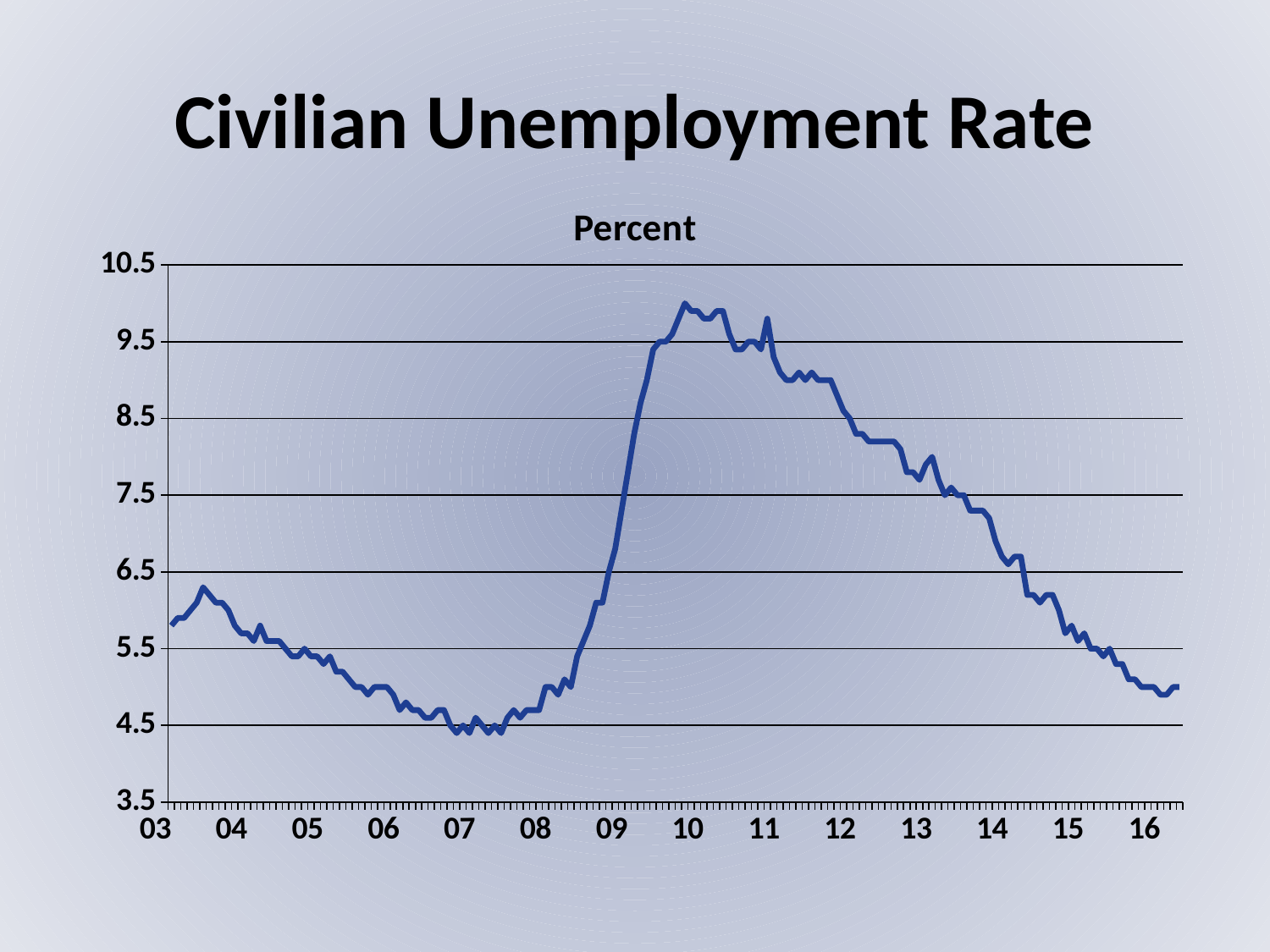
What unit label is shown above the chart's plot area? Percent Is the unemployment rate at the start of 2016 greater or less than 5.5? less In which year labelled on the x axis does the unemployment rate reach its highest point? 09 Does the unemployment rate rise or fall between 2011 and 2016? fall What kind of chart is shown on the slide? line chart What is the title of the chart? Civilian Unemployment Rate Is the unemployment rate at the start of 2010 greater or less than 9.5? greater Is the unemployment rate at the start of 2007 greater or less than 5.5? less Which is higher, the unemployment rate at the start of 2004 or at the start of 2014? 2014 Does the unemployment rate rise or fall between 2008 and 2009? rise